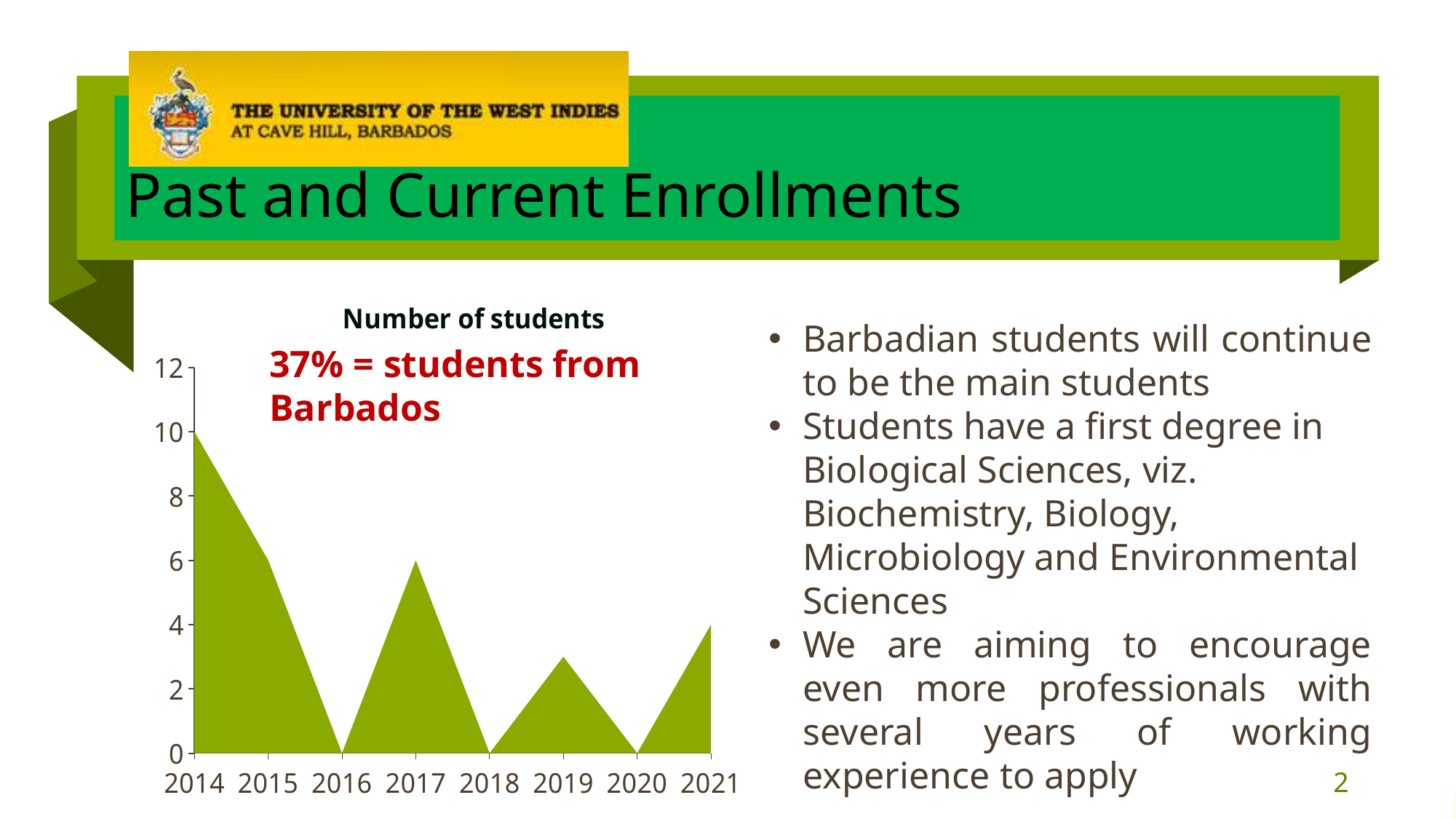
Is the number of students in 2019 greater or less than 4? less What is the number of students in 2014? 10 What is the title of the chart? Number of students How many years are shown on the x axis of the chart? 8 Does the number of students rise or fall from 2014 to 2016? fall What is the number of students in 2016? 0 What is the number of students in 2015? 6 Which year has the highest number of students? 2014 How many years show 0 students? 3 What is the difference between the number of students in 2014 and in 2021? 6 What is the number of students in 2021? 4 What kind of chart is shown on the slide? area chart